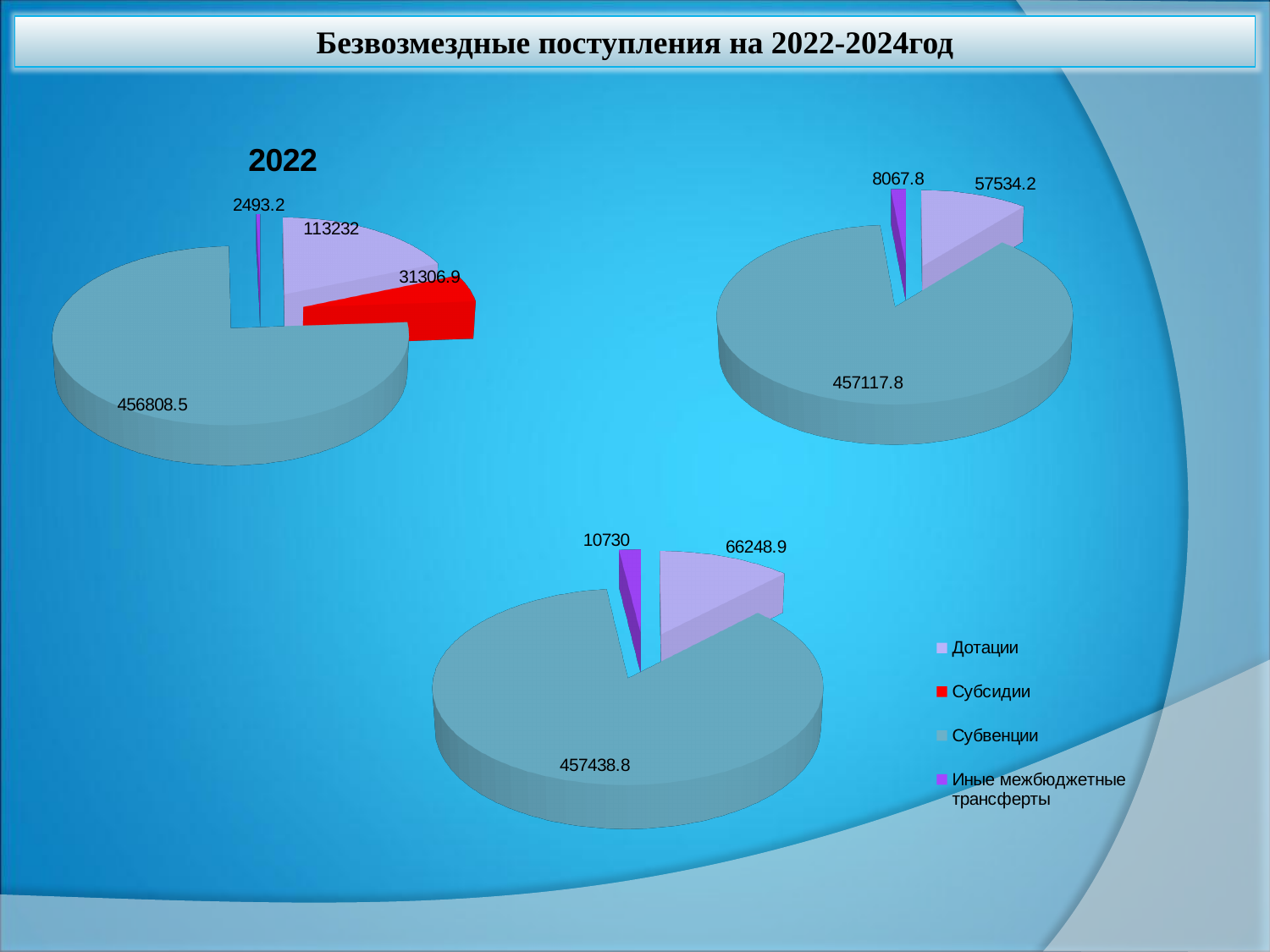
In the top-right pie chart, what is the value for Дотации? 57534.2 In the top-right pie chart, which is larger: Дотации or Иные межбюджетные трансферты? Дотации How many slices does the pie chart titled 2022 have? 4 In the bottom pie chart, what is the difference between Дотации and Иные межбюджетные трансферты? 55518.9 In the pie chart titled 2022, what is the value for Субвенции? 456808.5 How many entries does the legend on the slide list? 4 In the pie chart titled 2022, which category has the largest slice? Субвенции In the pie chart titled 2022, which category has the smallest slice? Иные межбюджетные трансферты In the bottom pie chart, what is the value for Иные межбюджетные трансферты? 10730 In the pie chart titled 2022, what is the value for Субсидии? 31306.9 In the pie chart titled 2022, what is the difference between Дотации and Субсидии? 81925.1 What type of chart is used on this slide? Pie chart